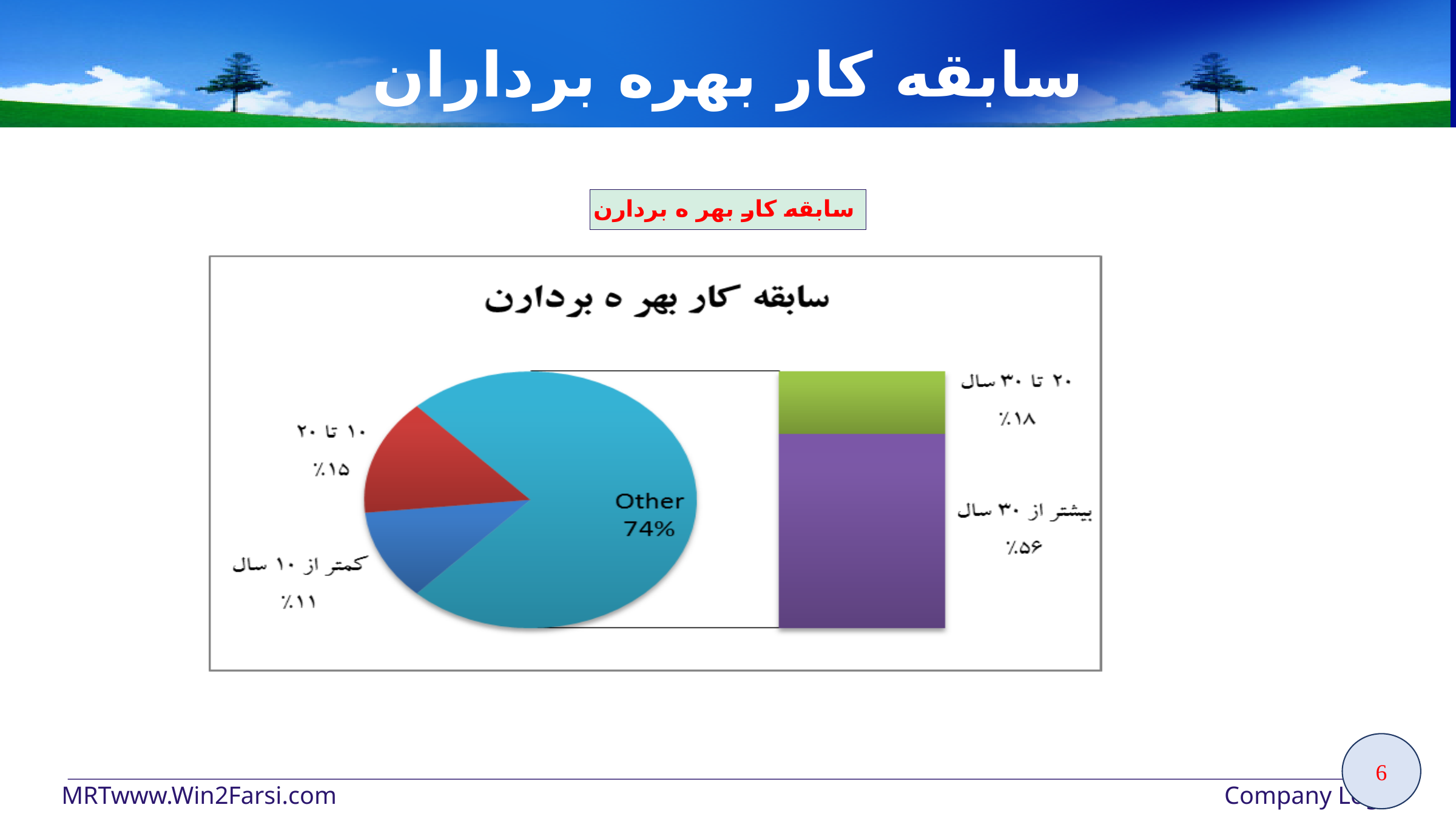
What percentage is shown for 'بیشتر از ۳۰ سال' (more than 30 years)? ۵۶٪ What is the title of the chart? سابقه کار بهر ه بردارن What percentage is shown for '۲۰ تا ۳۰ سال' (20 to 30 years)? ۱۸٪ What percentage is shown for the 'Other' slice of the pie? 74% Which experience category has the largest percentage? بیشتر از ۳۰ سال Which experience category has the smallest percentage? کمتر از ۱۰ سال What kind of chart is shown on the slide? pie chart (with a bar breakdown of the 'Other' slice) Which is larger: the percentage for '۱۰ تا ۲۰' or for '۲۰ تا ۳۰ سال'? ۲۰ تا ۳۰ سال What percentage is shown for 'کمتر از ۱۰ سال' (less than 10 years)? ۱۱٪ What percentage is shown for '۱۰ تا ۲۰' (10 to 20 years)? ۱۵٪ What is the total of the two segments in the stacked bar ('۲۰ تا ۳۰ سال' and 'بیشتر از ۳۰ سال')? ۷۴٪ What is the difference between the percentages for 'بیشتر از ۳۰ سال' and '۲۰ تا ۳۰ سال'? ۳۸٪